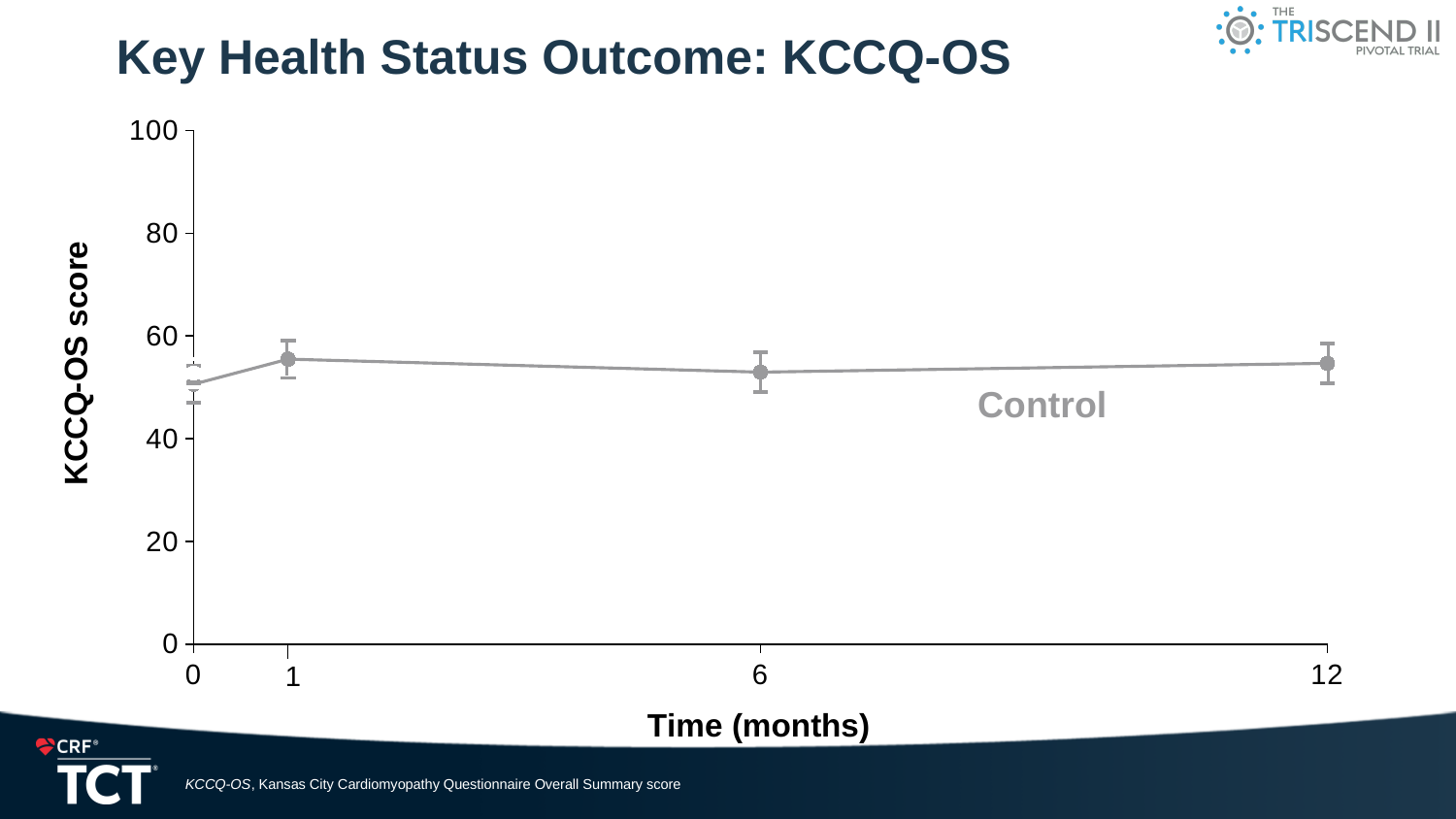
Is the KCCQ-OS score for the Control group at 12 months greater or less than 60? less How many time points are plotted on the chart? 4 Which has the higher KCCQ-OS score for the Control group: 0 months or 1 month? 1 month What kind of chart is shown on the slide? line chart Is the KCCQ-OS score for the Control group at 6 months greater or less than 80? less How many series are plotted on the chart? 1 What is the name of the series plotted on the chart? Control What are the time points shown on the x axis of the chart? 0, 1, 6, 12 Is the KCCQ-OS score for the Control group at 0 months greater or less than 40? greater What is the title of the slide's chart? Key Health Status Outcome: KCCQ-OS